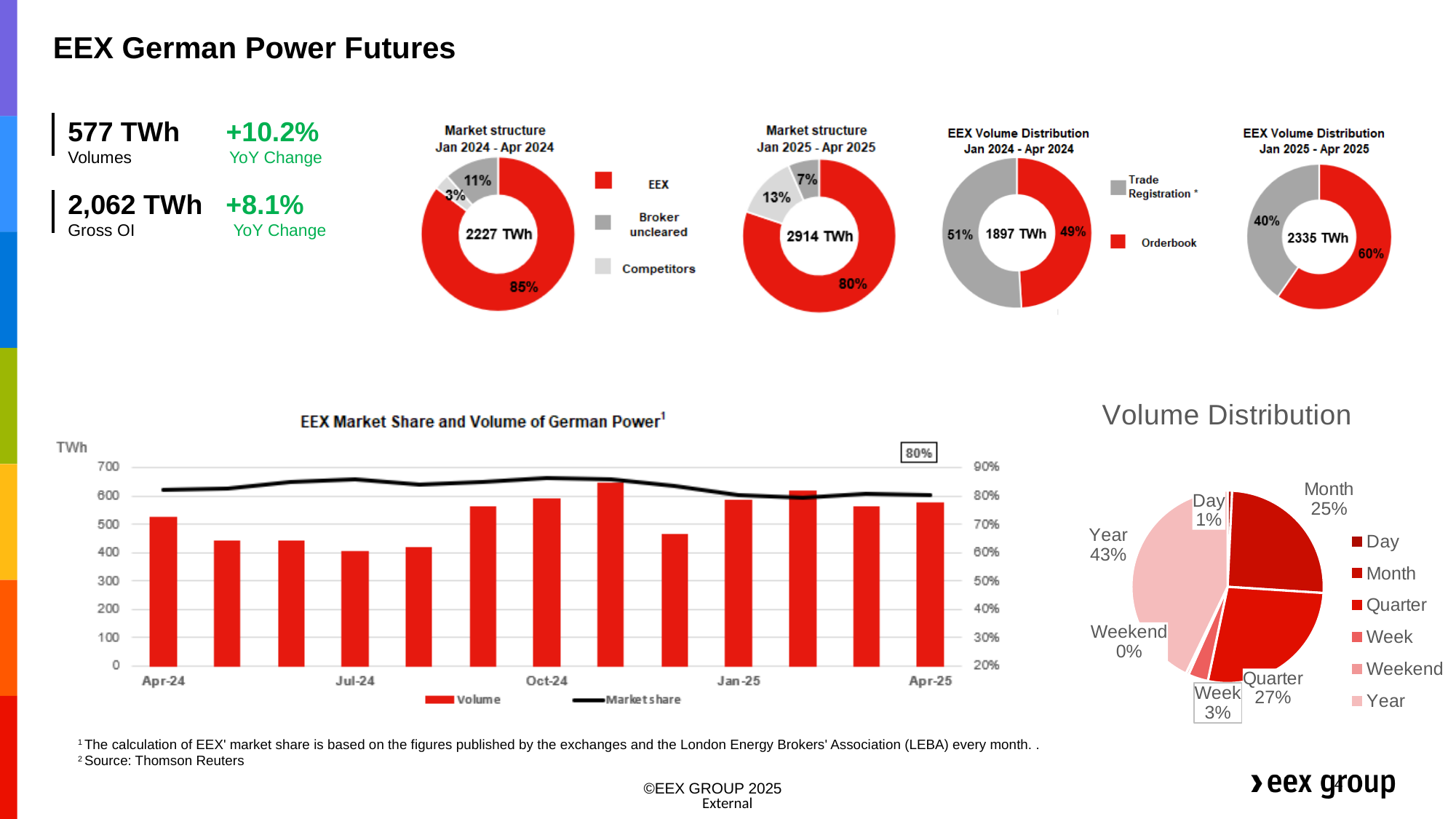
In the Market structure Jan 2024 - Apr 2024 donut chart, what share does EEX hold? 85% In the Volume Distribution pie chart, what share does Quarter have? 27% In the EEX Volume Distribution Jan 2024 - Apr 2024 donut chart, what share is Trade Registration? 51% In the EEX Market Share and Volume of German Power chart, how many series does the legend list? 2 In the Market structure Jan 2025 - Apr 2025 donut chart, what share is Broker uncleared? 7% In the Volume Distribution pie chart, which category has the largest share? Year In the EEX Volume Distribution Jan 2025 - Apr 2025 donut chart, which segment is larger, Orderbook or Trade Registration? Orderbook In the Market structure Jan 2025 - Apr 2025 donut chart, what total volume is shown in the centre? 2914 TWh How many categories does the legend of the Volume Distribution pie chart list? 6 In the EEX Market Share and Volume of German Power chart, is the Volume for Jul-24 greater or less than 500? less In the EEX Market Share and Volume of German Power chart, is the Volume for Apr-24 greater or less than 500? greater By how many percentage points did the EEX share in the Market structure charts fall from Jan-Apr 2024 to Jan-Apr 2025? 5 percentage points